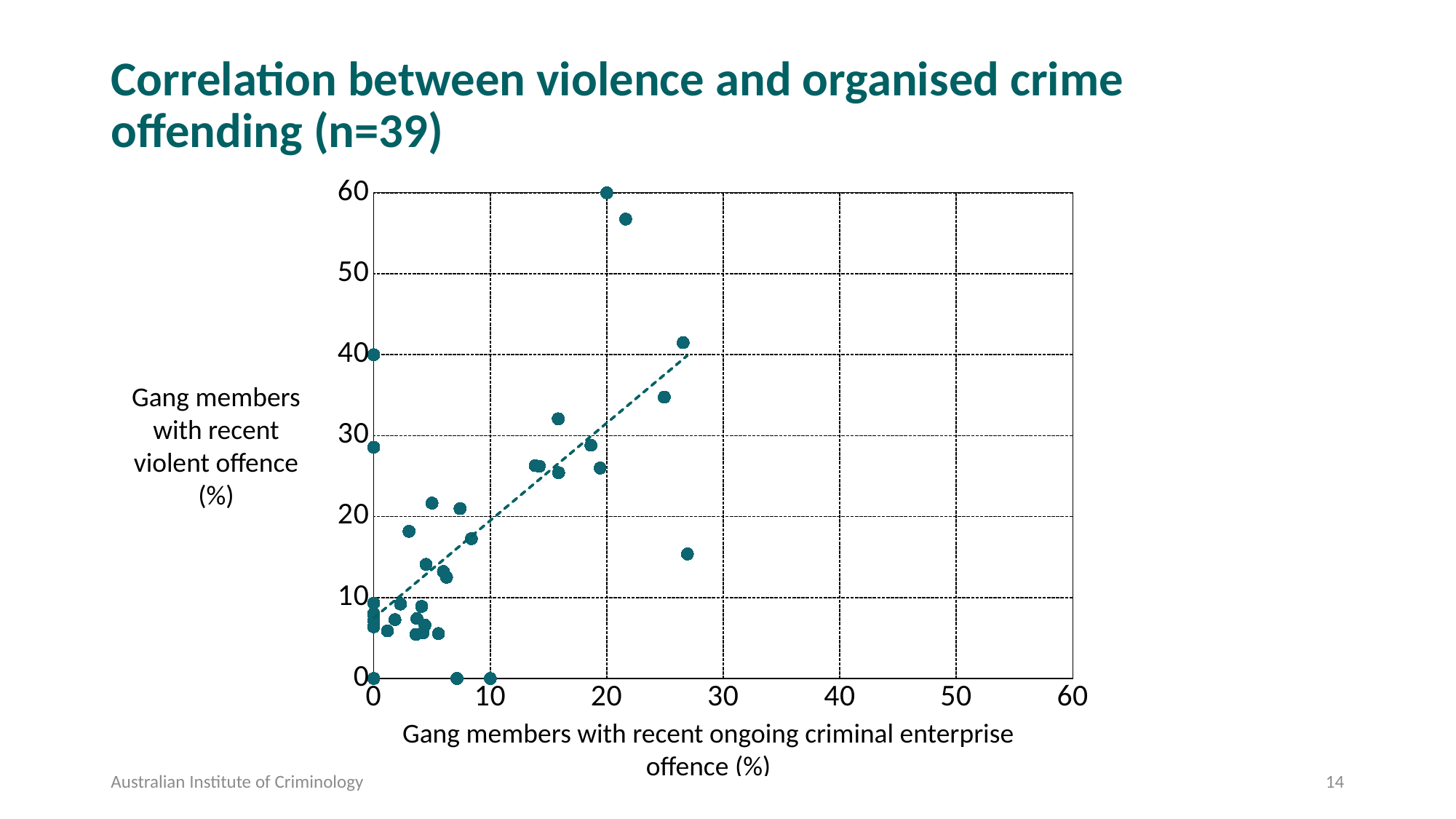
What is the maximum value shown on the vertical axis of the chart? 60 According to the chart title, how many gangs (n) are plotted? 39 Are most of the plotted points located below or above 30 on the vertical axis? below Is the highest plotted value for gang members with recent violent offence greater or less than 50? greater Does the dashed trend line rise or fall as the criminal enterprise offence percentage increases? Rises What kind of chart is shown on the slide? Scatter chart Is the highest plotted value for gang members with recent ongoing criminal enterprise offence greater or less than 40? less What is the title of the chart on the slide? Correlation between violence and organised crime offending (n=39) What is the label of the horizontal axis of the chart? Gang members with recent ongoing criminal enterprise offence (%)